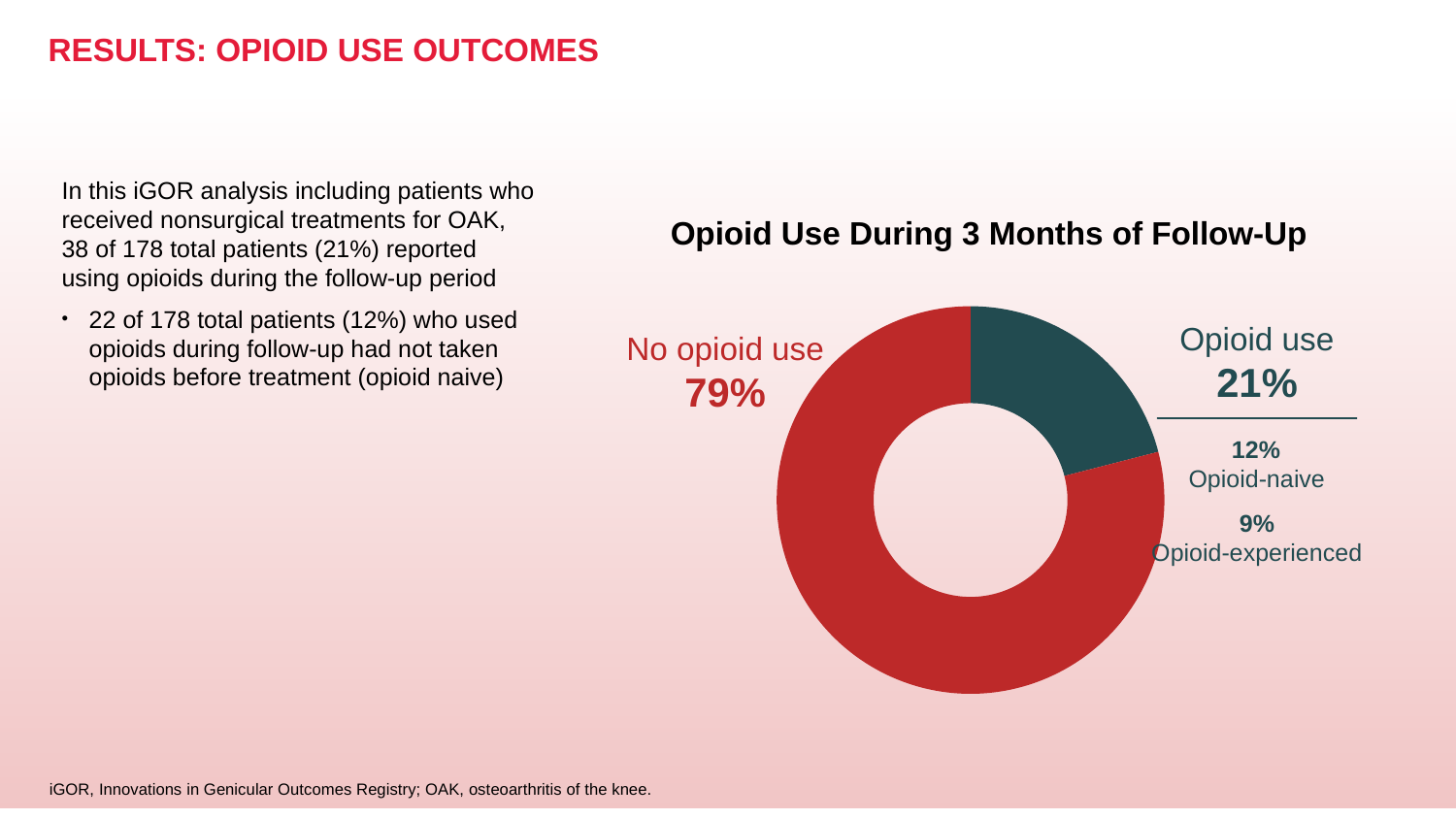
Which category is shown in the dark teal colour on the chart? Opioid use (21%) What is the title of the chart? Opioid Use During 3 Months of Follow-Up What is the difference between the opioid-naive and opioid-experienced shares? 3% What is the difference between the no opioid use share and the opioid use share? 58% What percentage of patients reported opioid use during follow-up? 21% What share of patients were opioid-naive opioid users? 12% What kind of chart is shown on the slide? Donut (pie) chart What percentage of patients reported no opioid use during follow-up? 79% What share of patients were opioid-experienced opioid users? 9% What is the combined share of the opioid-naive and opioid-experienced groups? 21% Which category has the largest share of the chart? No opioid use Which is larger, the opioid-naive share or the opioid-experienced share? Opioid-naive